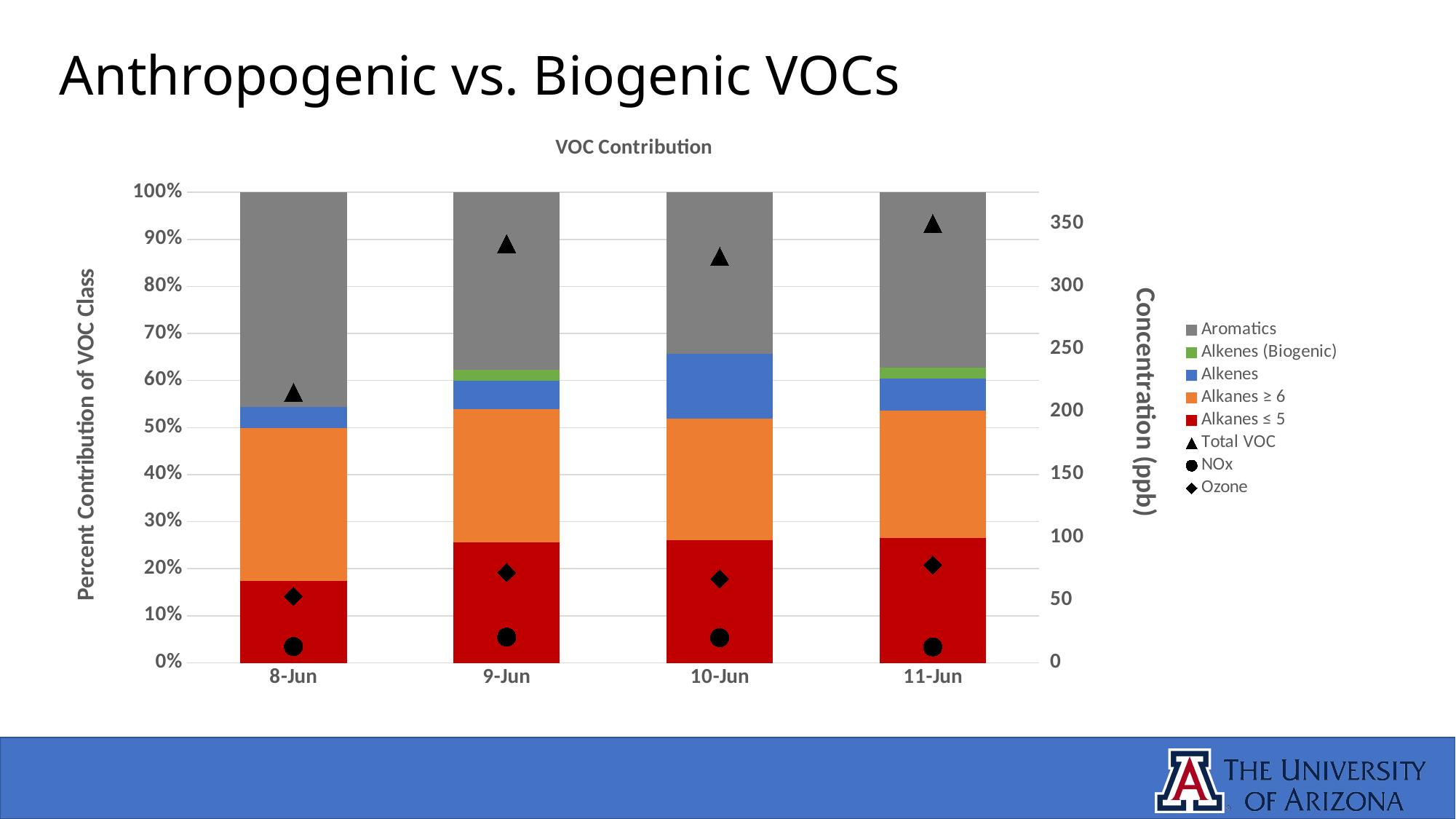
Which date has the larger Total VOC concentration, 8-Jun or 9-Jun? 9-Jun On which date is the Total VOC concentration highest? 11-Jun On which date is the Total VOC concentration lowest? 8-Jun On which date is the Ozone concentration lowest? 8-Jun What is the title of the chart? VOC Contribution Is the percent contribution of Alkanes ≤ 5 on 8-Jun greater or less than 20%? less What kind of chart is used to show the VOC class contributions? bar chart How many dates are shown on the x axis of the chart? 4 What is the label of the right-hand vertical axis? Concentration (ppb) Is the Total VOC concentration on 8-Jun greater or less than 250 ppb? less Is the Total VOC concentration on 11-Jun greater or less than 300 ppb? greater How many series does the legend list? 8